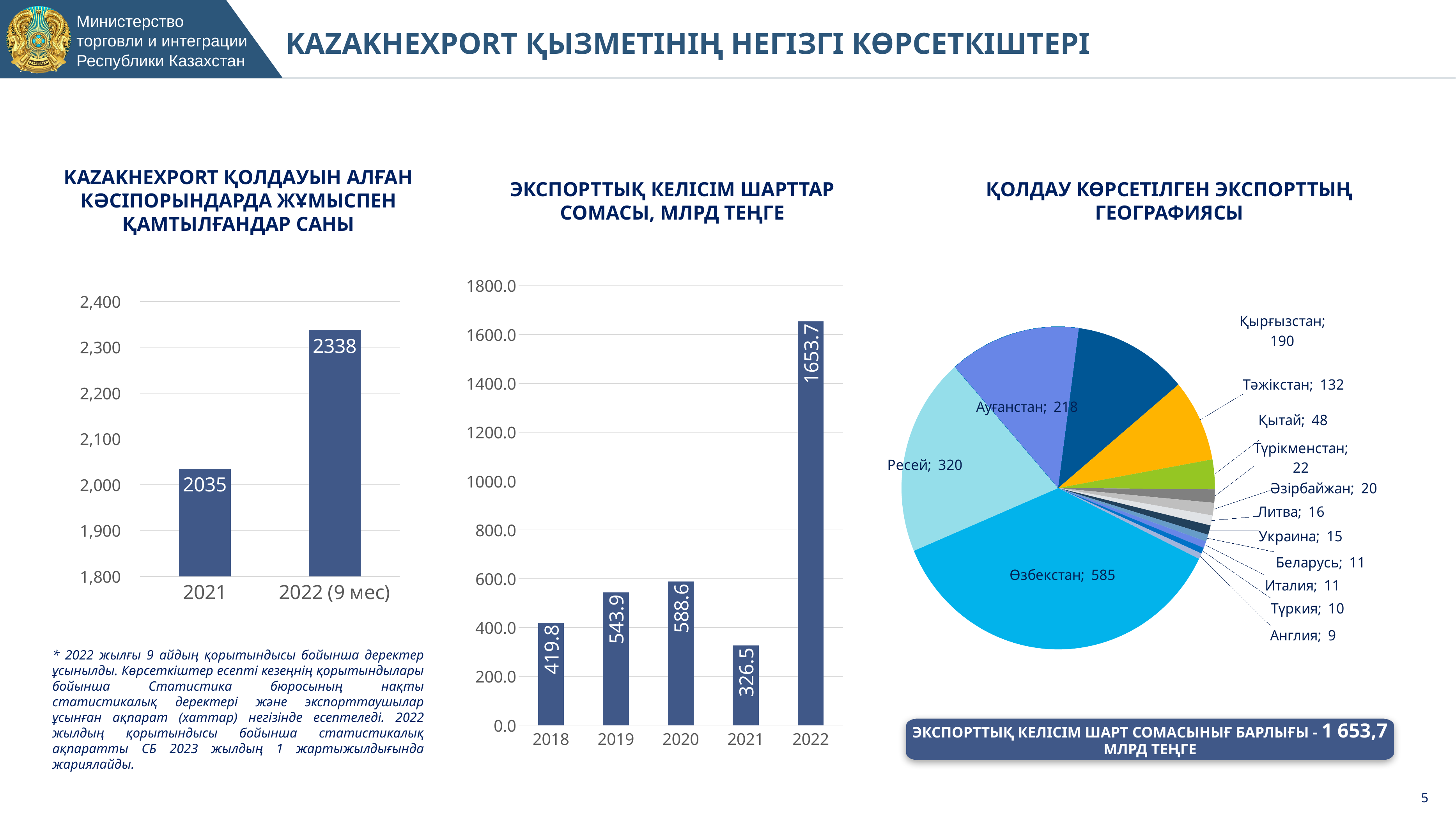
In the left chart, what is the difference between the 2022 (9 мес) value and the 2021 value? 303 In the right pie chart, what is the value for Ресей? 320 In the right pie chart, which country has the largest slice? Өзбекстан In the middle chart, how many years are shown on the x axis? 5 In the middle chart, which year has the lowest value? 2021 In the left chart (KAZAKHEXPORT ҚОЛДАУЫН АЛҒАН КӘСІПОРЫНДАРДА ЖҰМЫСПЕН ҚАМТЫЛҒАНДАР САНЫ), what is the value for 2021? 2035 In the middle chart, what is the difference between the 2022 value and the 2021 value? 1327.2 In the middle chart, which year has the highest value? 2022 In the left chart, what is the value for 2022 (9 мес)? 2338 In the middle chart, which is larger, the value for 2019 or the value for 2021? 2019 In the middle chart (ЭКСПОРТТЫҚ КЕЛІСІМ ШАРТТАР СОМАСЫ, МЛРД ТЕҢГЕ), what is the value for 2020? 588.6 What kind of chart is the right chart (ҚОЛДАУ КӨРСЕТІЛГЕН ЭКСПОРТТЫҢ ГЕОГРАФИЯСЫ)? pie chart